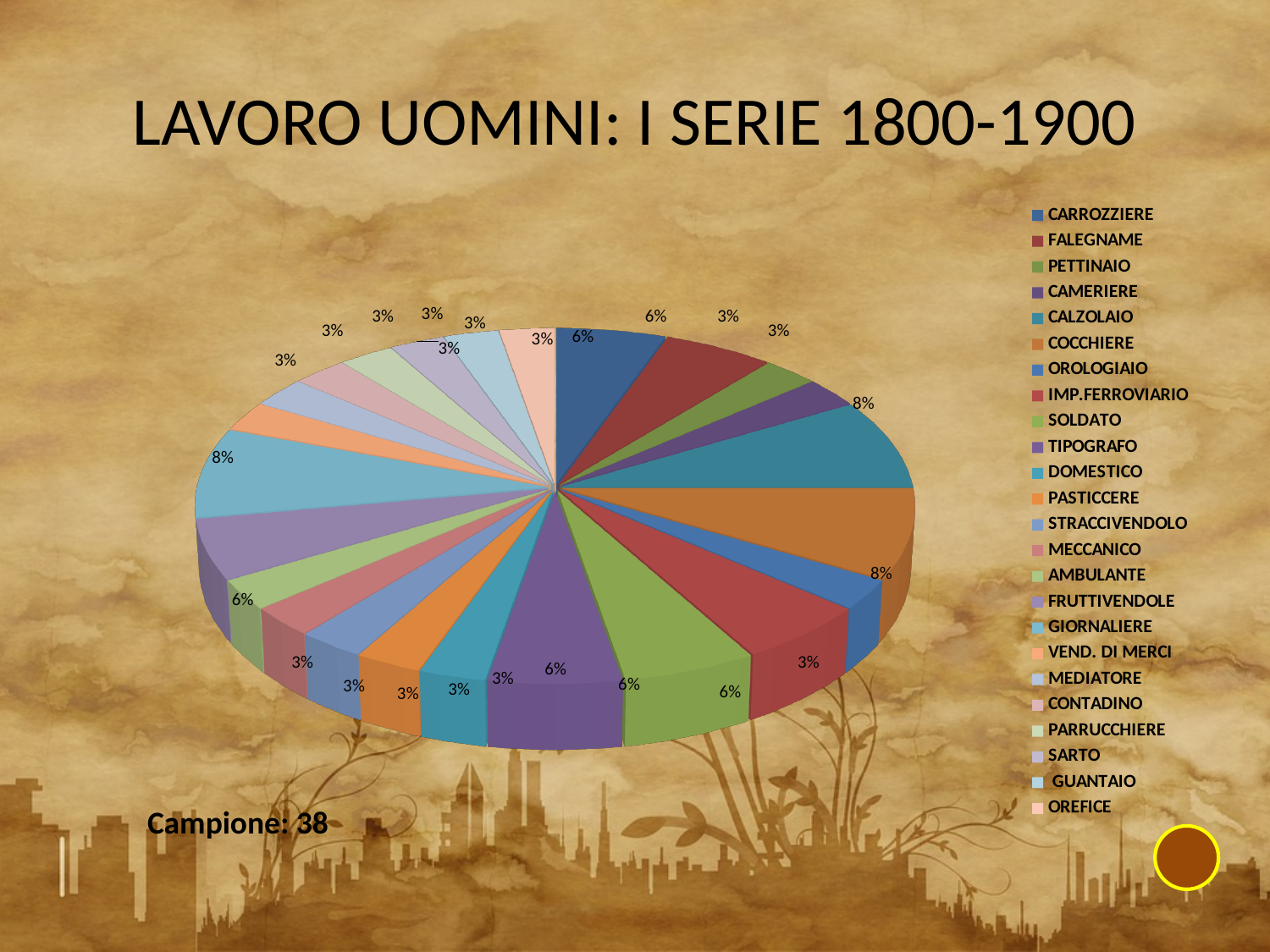
How many categories does the legend of the pie chart list? 24 Which legend entry is listed first in the chart's legend? CARROZZIERE What is the largest percentage shown on any slice of the pie chart? 8% What kind of chart is shown on the slide? pie chart What is the title of the chart? LAVORO UOMINI: I SERIE 1800-1900 What share of the pie does GIORNALIERE have? 8% What share of the pie does CALZOLAIO have? 8% What share of the pie does COCCHIERE have? 8% What is the smallest percentage shown on any slice of the pie chart? 3% What is the difference between the share of COCCHIERE and the share of FALEGNAME? 2% Which has the larger share, CARROZZIERE or FALEGNAME? Neither; both have 6%